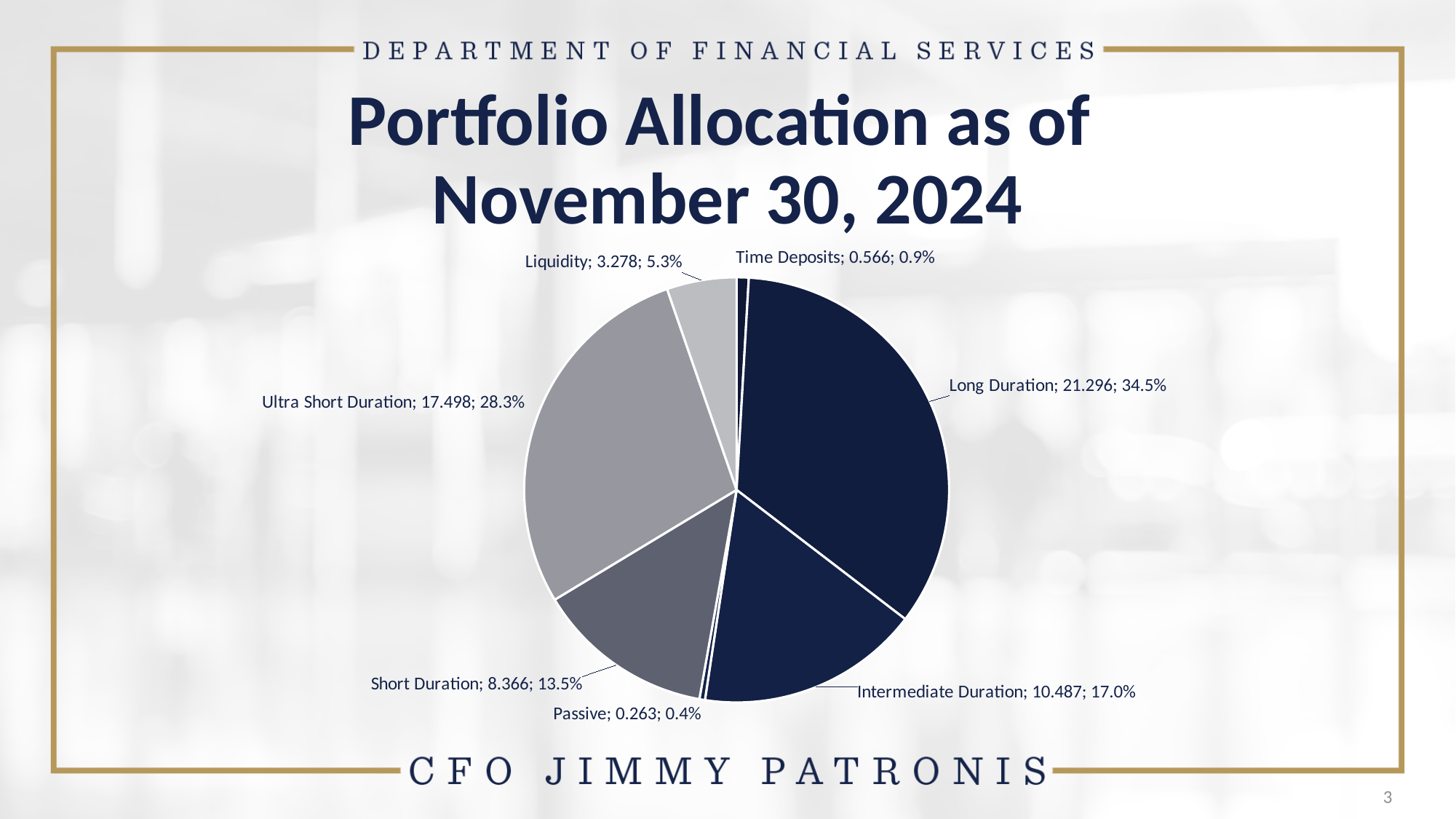
What is the value shown for Passive? 0.263 What percentage share does Ultra Short Duration have? 28.3% What is the difference between the values for Long Duration and Ultra Short Duration? 3.798 What percentage share does Time Deposits have? 0.9% Which is larger, Short Duration or Liquidity? Short Duration Which category has the smallest slice of the pie? Passive What is the value shown for Long Duration? 21.296 What kind of chart is shown on the slide? Pie chart What is the value shown for Intermediate Duration? 10.487 Which category has the largest slice of the pie? Long Duration How many categories are shown in the pie chart? 7 What is the title of the slide containing the chart? Portfolio Allocation as of November 30, 2024